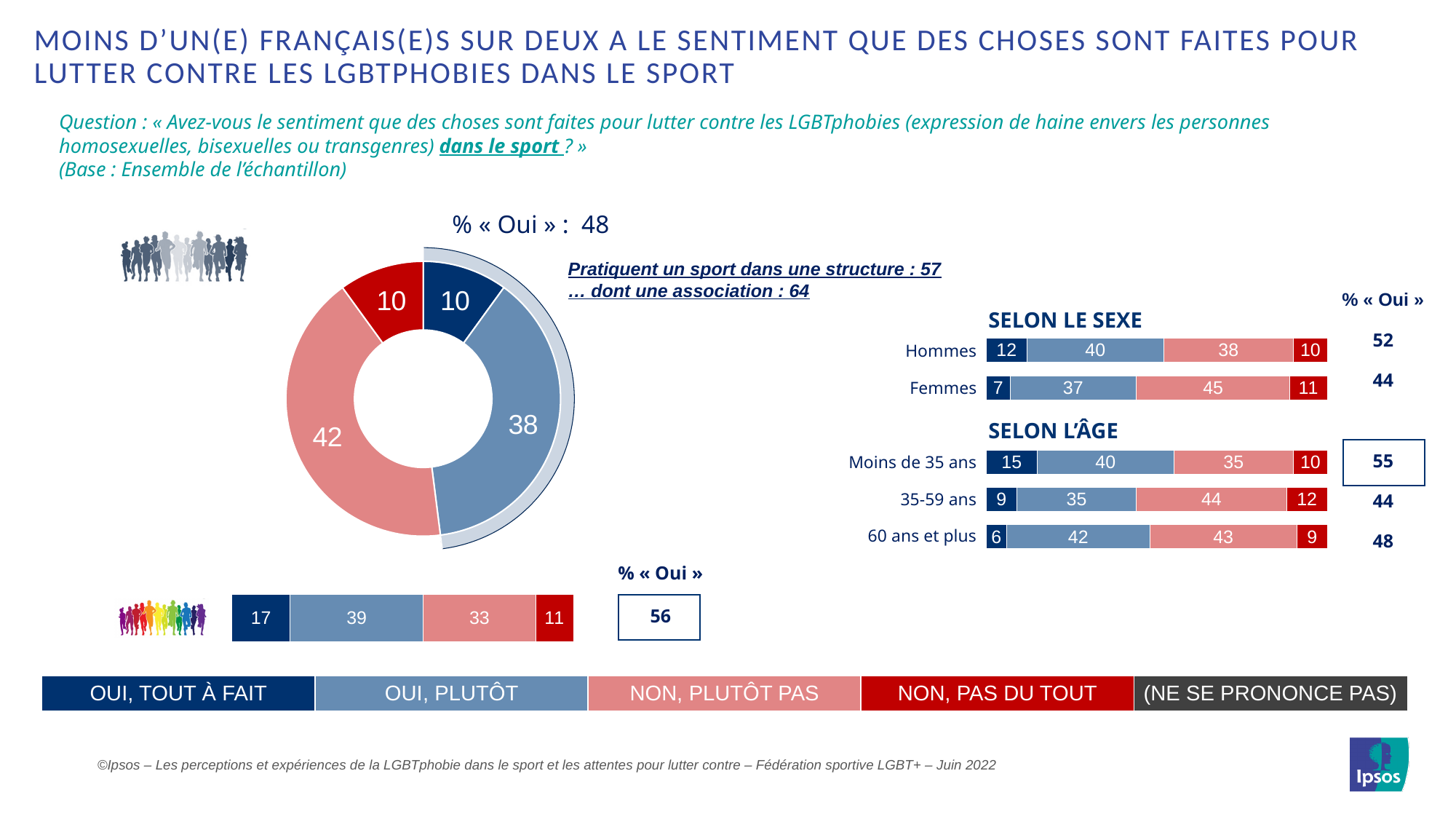
In the donut chart, which segment is the largest? Non, plutôt pas In the bottom-left stacked bar chart, what is the "Non, pas du tout" value? 11 In the "Selon l'âge" bar chart, what is the % « Oui » for 35-59 ans? 44 What kind of chart is the chart on the left showing the overall results? Donut chart In the "Selon le sexe" bar chart, which has the larger "Oui, plutôt" value, Hommes or Femmes? Hommes In the "Selon l'âge" bar chart, which age group has the highest "Oui, tout à fait" value? Moins de 35 ans How many response categories does the legend at the bottom of the slide list? 5 In the donut chart, what is the value for the "Oui, plutôt" segment? 38 In the "Selon le sexe" bar chart, what is the "Oui, tout à fait" value for Hommes? 12 In the "Selon le sexe" bar chart, what is the "Non, plutôt pas" value for Femmes? 45 In the "Selon l'âge" bar chart, what is the difference between the "Non, plutôt pas" values for 35-59 ans and Moins de 35 ans? 9 How many categories does the "Selon l'âge" bar chart show? 3